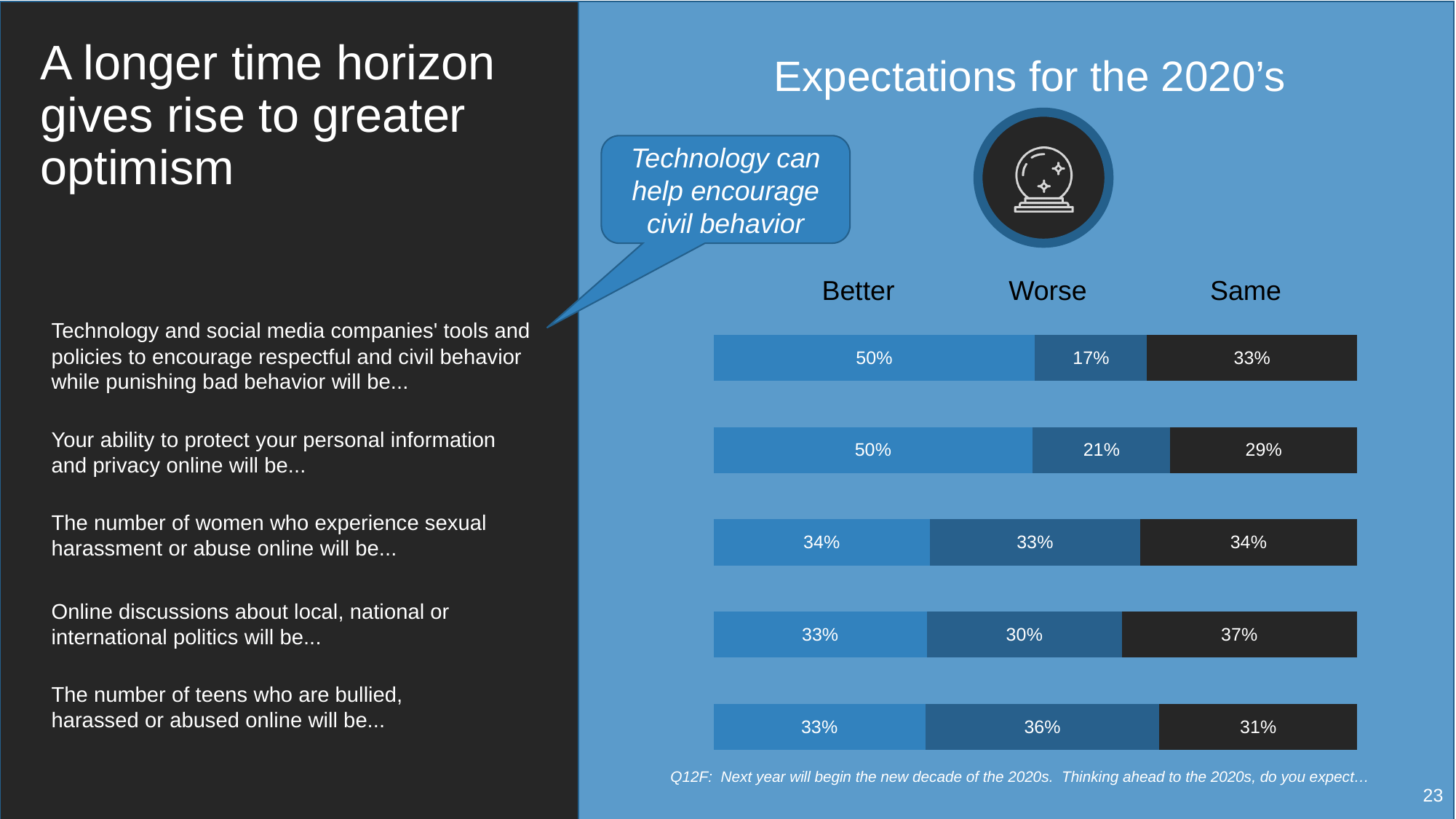
Which item has the lowest 'Worse' percentage? Technology and social media companies' tools and policies to encourage respectful and civil behavior For the number of teens who are bullied, harassed or abused online, is the 'Worse' share larger or the 'Same' share larger? Worse What is the difference between the 'Better' and 'Worse' percentages for the ability to protect personal information and privacy online? 29% How many items (bars) are shown in the chart? 5 What percentage expect technology and social media companies' tools and policies to encourage civil behavior will be better in the 2020's? 50% What percentage expect the number of teens who are bullied, harassed or abused online will be worse? 36% Which item has the highest 'Same' percentage? Online discussions about local, national or international politics What type of chart is shown on the slide? Stacked bar chart How many response categories does the chart show for each item? 3 What is the title of the chart? Expectations for the 2020's What percentage expect online discussions about local, national or international politics will be the same? 37% What percentage expect their ability to protect personal information and privacy online will be worse? 21%